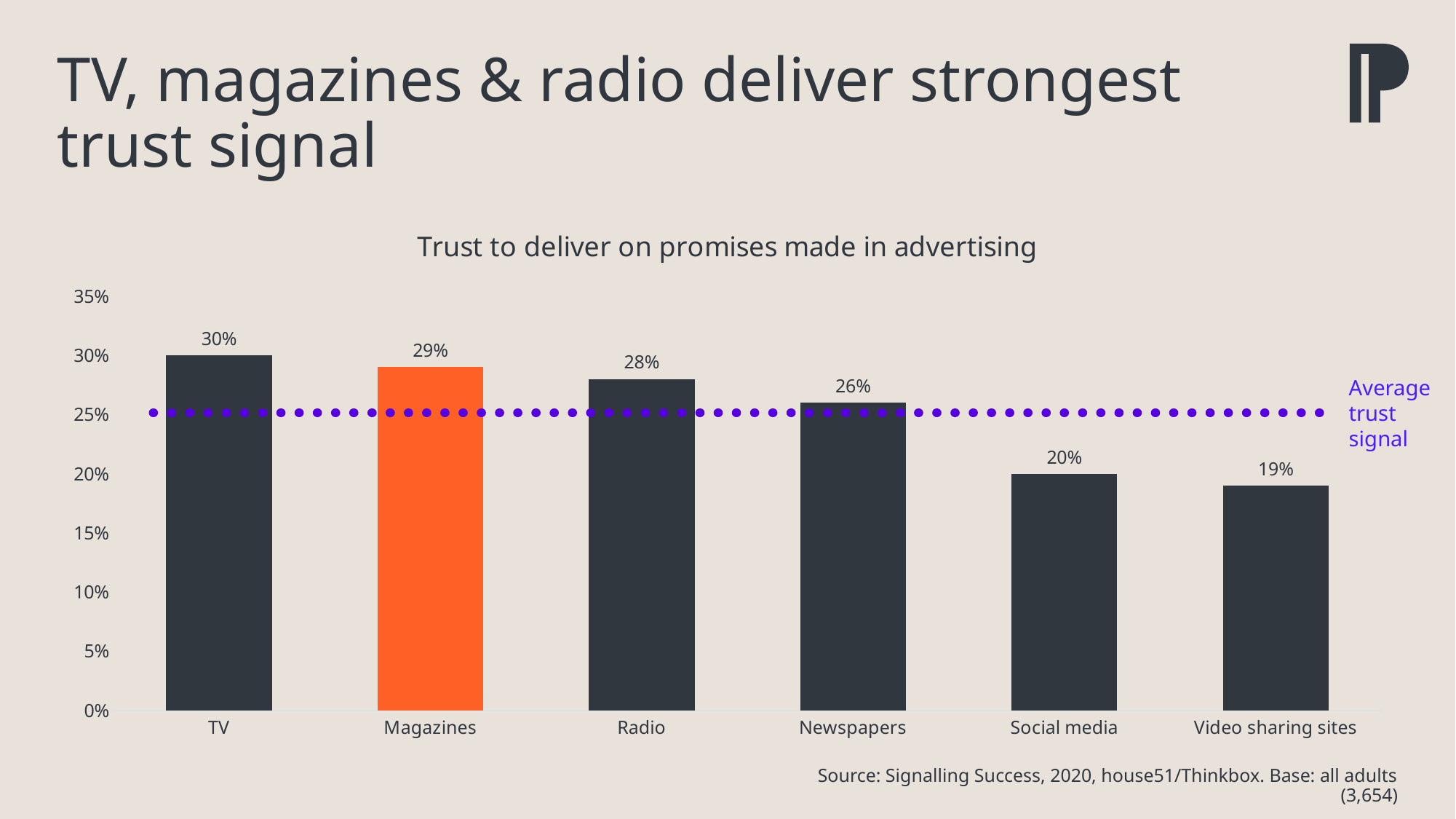
What is the difference between the values for TV and Video sharing sites? 11% What is the title of the chart? Trust to deliver on promises made in advertising What is the value for Magazines? 29% How many categories are shown on the x axis? 6 What is the value for Social media? 20% Which category has the highest value? TV What is the difference between the values for Radio and Social media? 8% Is the value for Social media greater or less than 25%? less Which is larger, the value for Radio or the value for Newspapers? Radio What is the value for Newspapers? 26% What kind of chart is shown on the slide? bar chart Which category has the lowest value? Video sharing sites